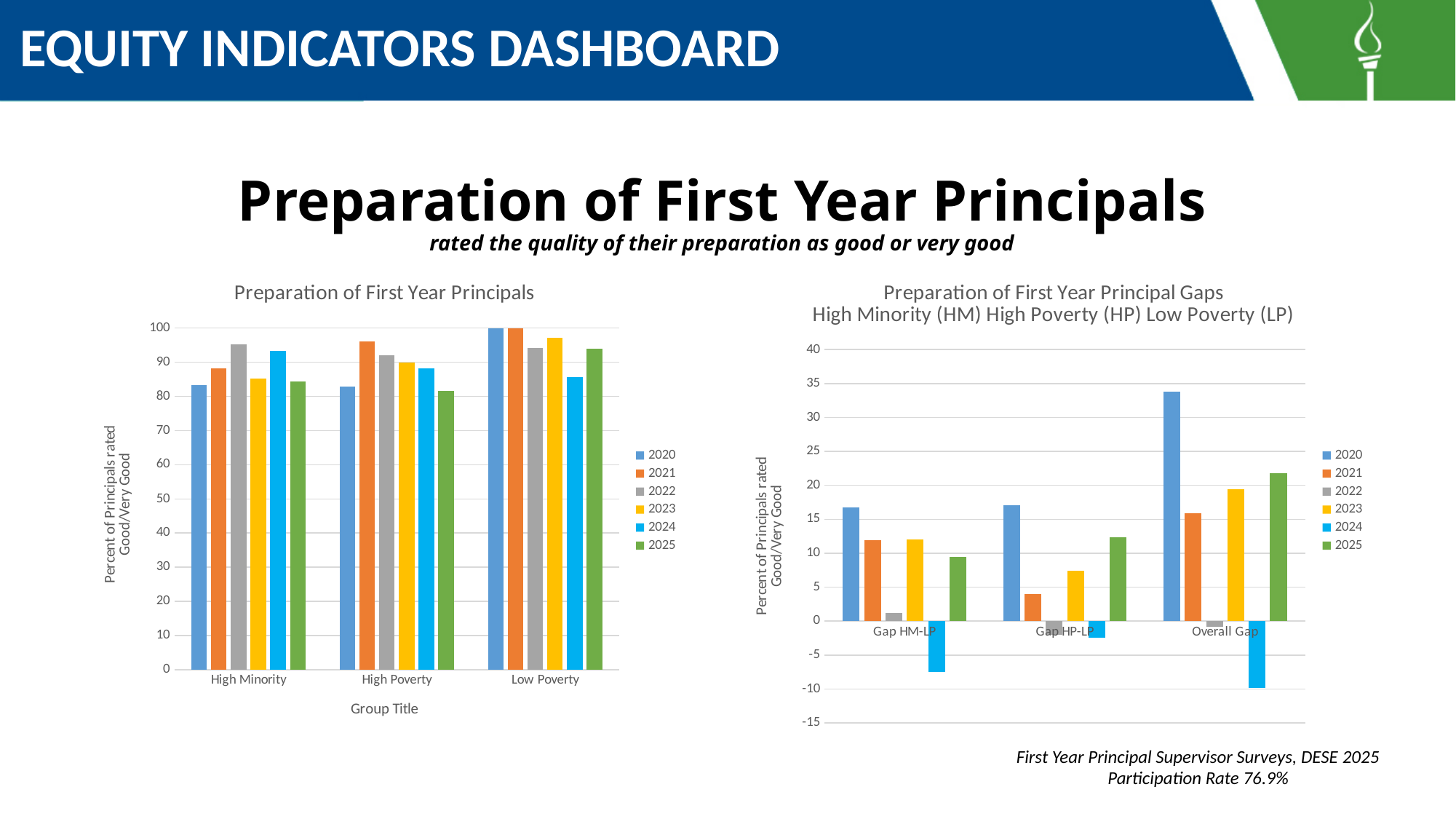
In the left chart 'Preparation of First Year Principals', which is larger for Low Poverty: the 2023 value or the 2024 value? 2023 In the left chart 'Preparation of First Year Principals', is the 2025 value for High Poverty greater or less than 90? less In the left chart 'Preparation of First Year Principals', which year has the highest value for High Minority? 2022 In the right chart 'Preparation of First Year Principal Gaps', which year has the highest Overall Gap? 2020 What is the x-axis title of the left chart 'Preparation of First Year Principals'? Group Title In the right chart 'Preparation of First Year Principal Gaps', is the 2020 Overall Gap greater or less than 30? greater What kind of chart is the left chart titled 'Preparation of First Year Principals'? bar chart In the right chart 'Preparation of First Year Principal Gaps', which year has the lowest value for Gap HM-LP? 2024 How many groups are shown on the x axis of the left chart 'Preparation of First Year Principals'? 3 How many series does the legend of the left chart 'Preparation of First Year Principals' list? 6 In the left chart 'Preparation of First Year Principals', is the 2024 value for High Minority greater or less than 90? greater How many gap categories are shown on the x axis of the right chart 'Preparation of First Year Principal Gaps'? 3